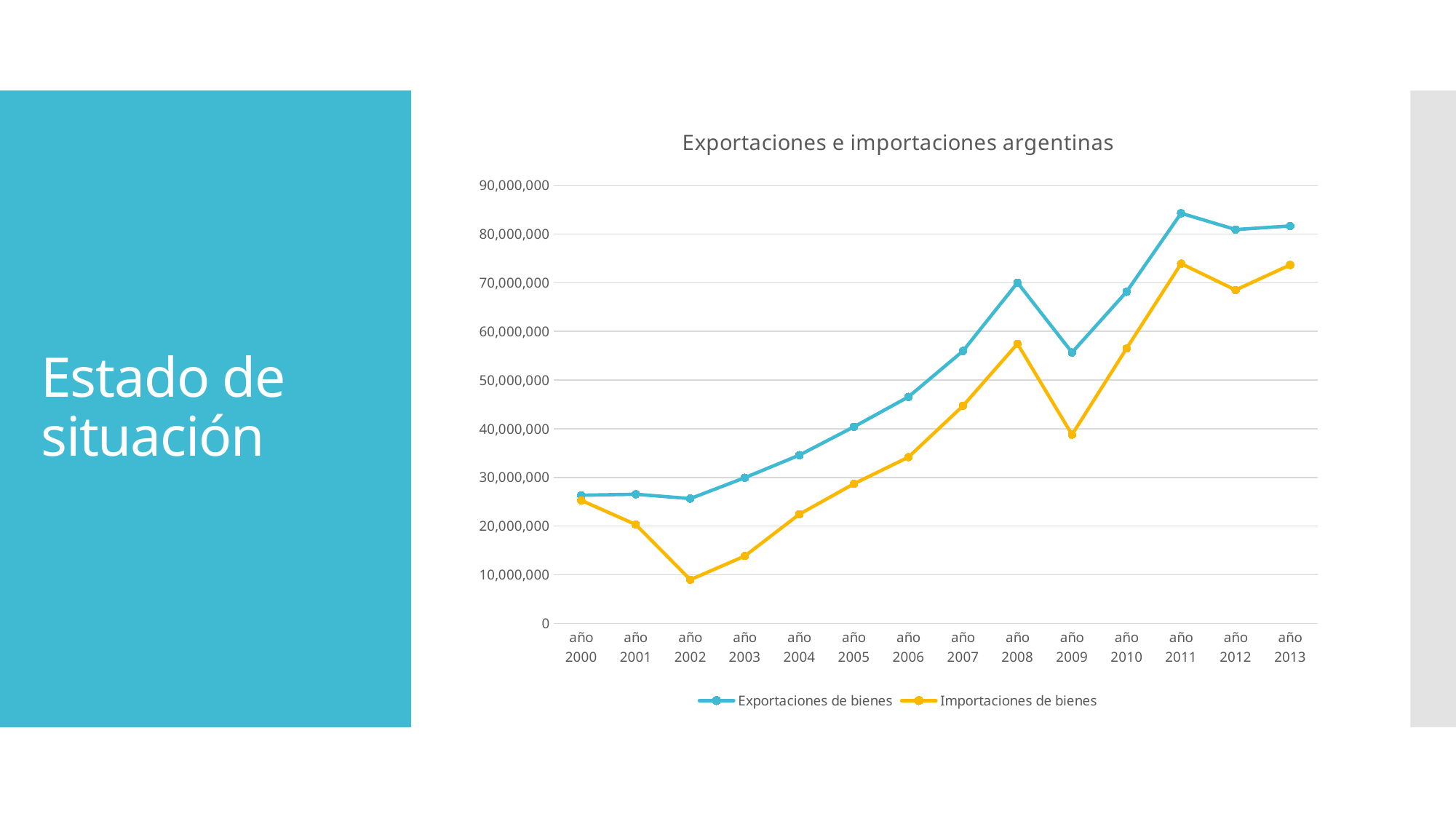
Is the value for Importaciones de bienes in año 2002 greater or less than 20,000,000? less In año 2009, which is larger: Exportaciones de bienes or Importaciones de bienes? Exportaciones de bienes Is the value for Exportaciones de bienes in año 2011 greater or less than 80,000,000? greater How many years are shown on the x axis? 14 In which year is the value for Exportaciones de bienes highest? año 2011 Do the values for Importaciones de bienes rise or fall from año 2000 to año 2002? Fall Is the value for Exportaciones de bienes in año 2008 greater or less than 60,000,000? greater How many series does the legend list? 2 In which year is the value for Importaciones de bienes lowest? año 2002 What kind of chart is shown on the slide? Line chart What is the title of the chart? Exportaciones e importaciones argentinas Which colour is used for the Importaciones de bienes line? Yellow